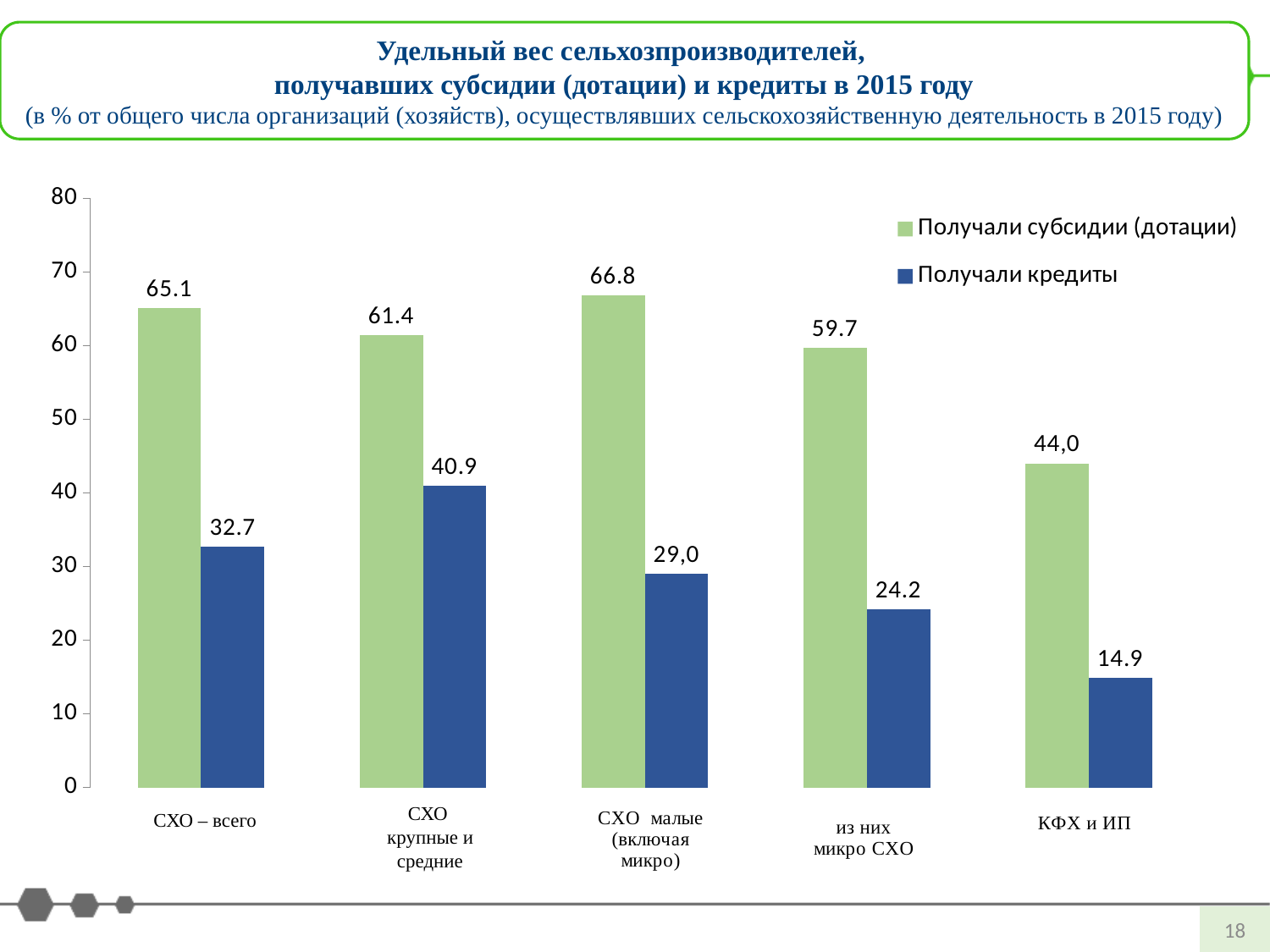
Which category has the highest value in the «Получали субсидии (дотации)» series? СХО малые (включая микро) What is the value for «СХО – всего» in the «Получали субсидии (дотации)» series? 65.1 Which colour represents the «Получали кредиты» series? Blue What kind of chart is shown on the slide? Bar chart Which is larger for «из них микро СХО»: the «Получали субсидии (дотации)» value or the «Получали кредиты» value? Получали субсидии (дотации) Is the «Получали кредиты» value for «СХО крупные и средние» greater or less than 40? greater What is the value for «СХО малые (включая микро)» in the «Получали кредиты» series? 29,0 What is the value for «КФХ и ИП» in the «Получали кредиты» series? 14.9 What is the difference between the «Получали субсидии (дотации)» and «Получали кредиты» values for «СХО крупные и средние»? 20.5 Which category has the lowest value in the «Получали кредиты» series? КФХ и ИП How many series does the legend list? 2 How many categories are shown on the x axis? 5